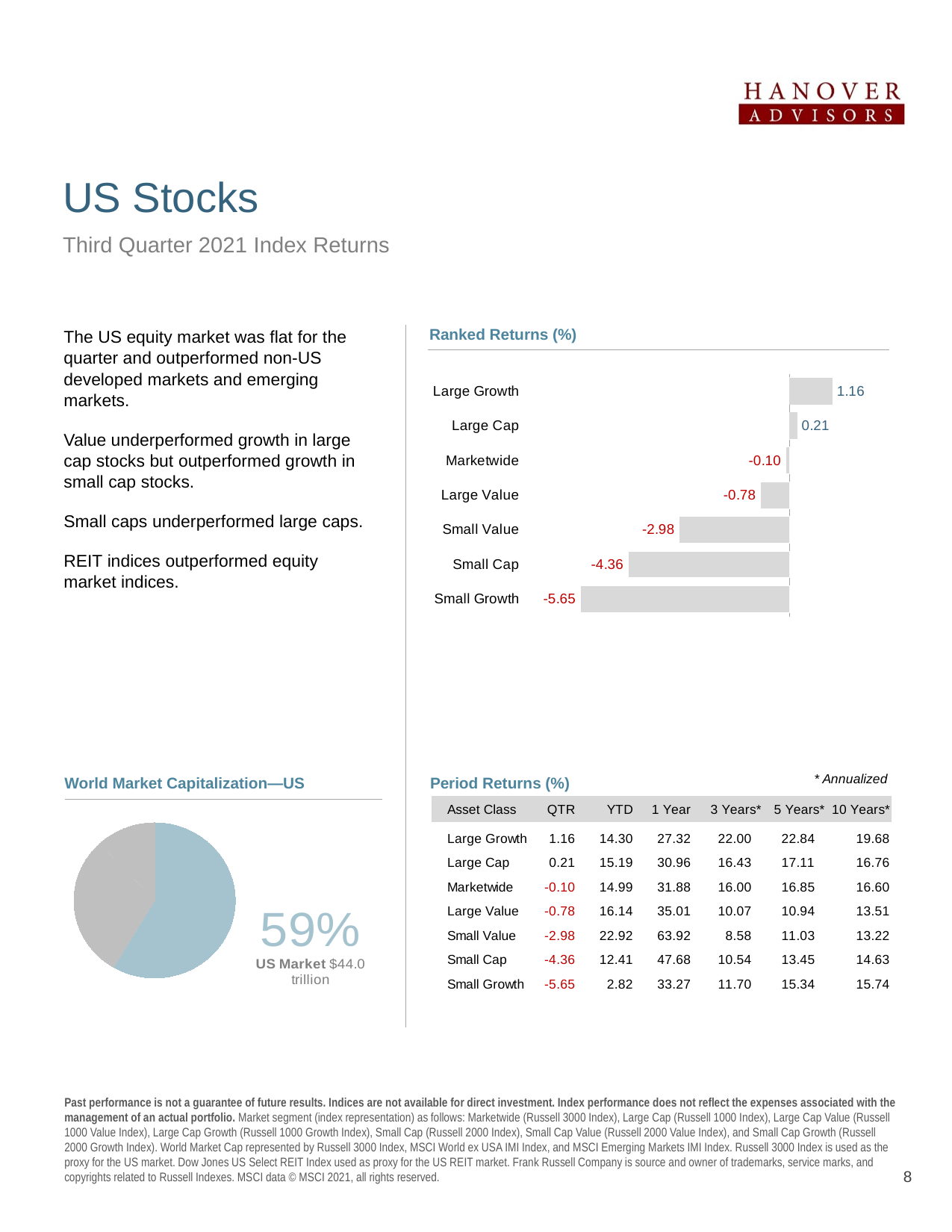
What kind of chart is the Ranked Returns (%) chart? Bar chart In the Ranked Returns (%) chart, what is the value for Marketwide? -0.10 In the Ranked Returns (%) chart, which category has the highest value? Large Growth In the World Market Capitalization—US chart, what share of world market capitalization does the US Market represent? 59% What kind of chart is the World Market Capitalization—US chart? Pie chart In the Ranked Returns (%) chart, what is the value for Large Growth? 1.16 In the Ranked Returns (%) chart, what is the difference between the values for Large Growth and Small Growth? 6.81 In the World Market Capitalization—US chart, what is the value of the US Market? $44.0 trillion How many categories are shown in the Ranked Returns (%) chart? 7 In the Ranked Returns (%) chart, which category has the lowest value? Small Growth In the Ranked Returns (%) chart, what is the value for Small Cap? -4.36 In the Ranked Returns (%) chart, which is larger, the value for Large Value or the value for Small Value? Large Value